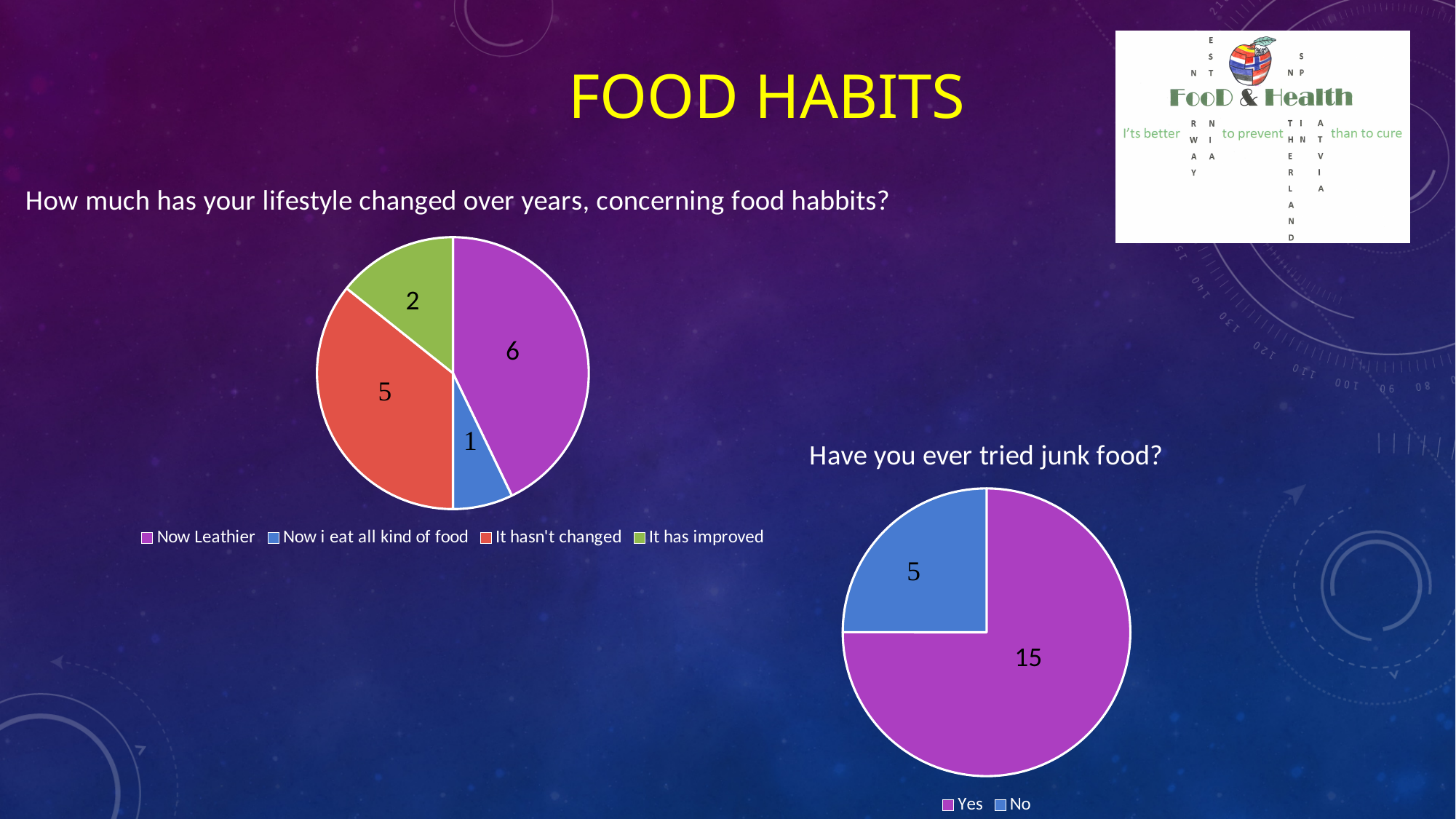
In the chart 'How much has your lifestyle changed over years, concerning food habbits?', what is the difference between 'Now Leathier' and 'It has improved'? 4 In the chart 'How much has your lifestyle changed over years, concerning food habbits?', what is the value for 'It has improved'? 2 In the chart 'How much has your lifestyle changed over years, concerning food habbits?', which category has the largest slice? Now Leathier In the chart 'Have you ever tried junk food?', what is the value for 'No'? 5 In the chart 'How much has your lifestyle changed over years, concerning food habbits?', what is the value for 'Now Leathier'? 6 In the chart 'How much has your lifestyle changed over years, concerning food habbits?', what is the value for 'It hasn't changed'? 5 In the chart 'How much has your lifestyle changed over years, concerning food habbits?', how many categories does the legend list? 4 In the chart 'Have you ever tried junk food?', what is the difference between 'Yes' and 'No'? 10 What type of chart is used for 'Have you ever tried junk food?'? Pie chart In the chart 'Have you ever tried junk food?', what share of the pie does 'Yes' represent? 75% In the chart 'Have you ever tried junk food?', what is the value for 'Yes'? 15 In the chart 'How much has your lifestyle changed over years, concerning food habbits?', which category has the smallest slice? Now i eat all kind of food